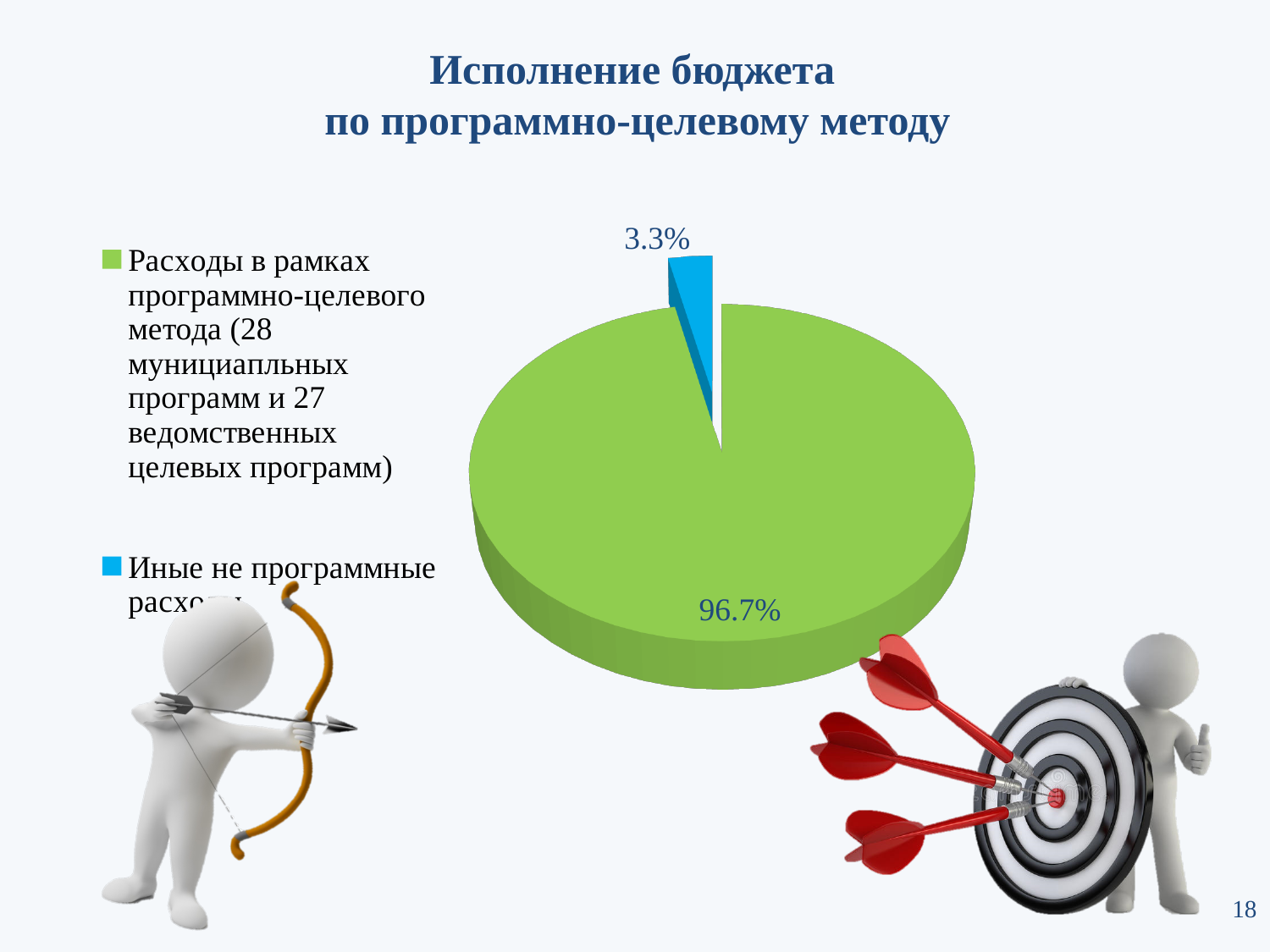
Which slice of the pie is the smallest? Иные не программные расходы How many entries does the legend list? 2 What is the title of the slide containing the pie chart? Исполнение бюджета по программно-целевому методу What share of the pie is labelled for the blue slice (Иные не программные расходы)? 3.3% What share of the pie is labelled for the green slice (Расходы в рамках программно-целевого метода)? 96.7% What colour is the slice representing Иные не программные расходы? blue What kind of chart is shown on the slide? pie chart According to the legend, how many municipal programmes are included in the programme-target method expenditures? 28 Which slice of the pie is the largest? Расходы в рамках программно-целевого метода How many slices does the pie chart have? 2 Which is larger: the share for Расходы в рамках программно-целевого метода or the share for Иные не программные расходы? Расходы в рамках программно-целевого метода What is the difference in percentage points between the green slice (96.7%) and the blue slice (3.3%)? 93.4